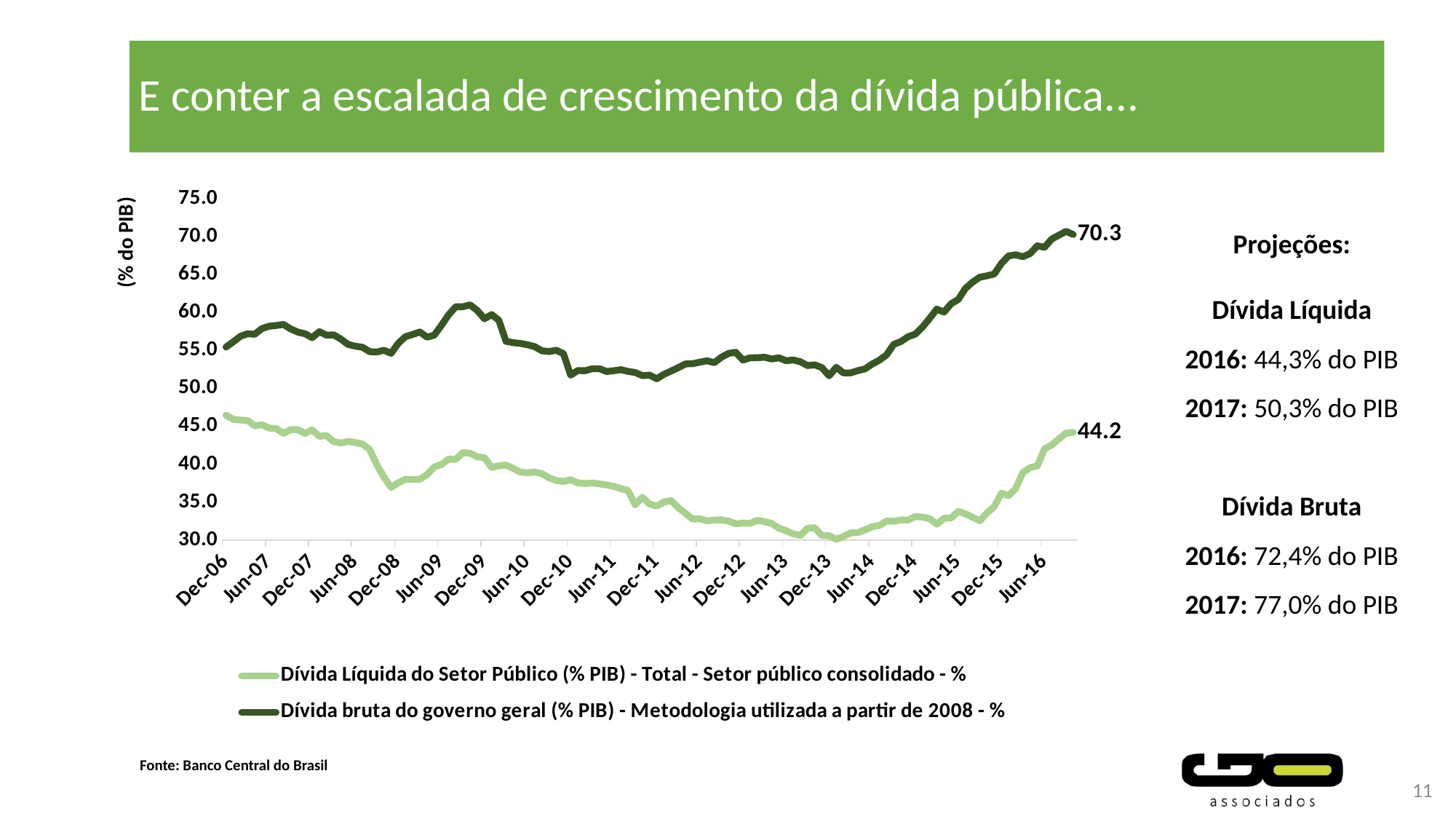
How many series does the legend list? 2 Is the value of the Dívida Líquida series at Dec-13 greater or less than 35.0? less Is the value of the Dívida Líquida series at Dec-08 greater or less than 40.0? less What is the difference between the final labelled values of the gross debt (70.3) and net debt (44.2) series? 26.1 Does the Dívida bruta series rise or fall between Jun-14 and Jun-16? rise What source is cited for the chart data? Banco Central do Brasil Is the value of the Dívida bruta series at Dec-06 greater or less than 50.0? greater What is the label on the vertical axis of the chart? (% do PIB) Which series has the higher value at the end of the chart, Dívida bruta or Dívida Líquida? Dívida bruta do governo geral What kind of chart is shown on the slide? line chart What is the last labelled value of the 'Dívida bruta do governo geral' series? 70.3 What is the last labelled value of the 'Dívida Líquida do Setor Público' series? 44.2